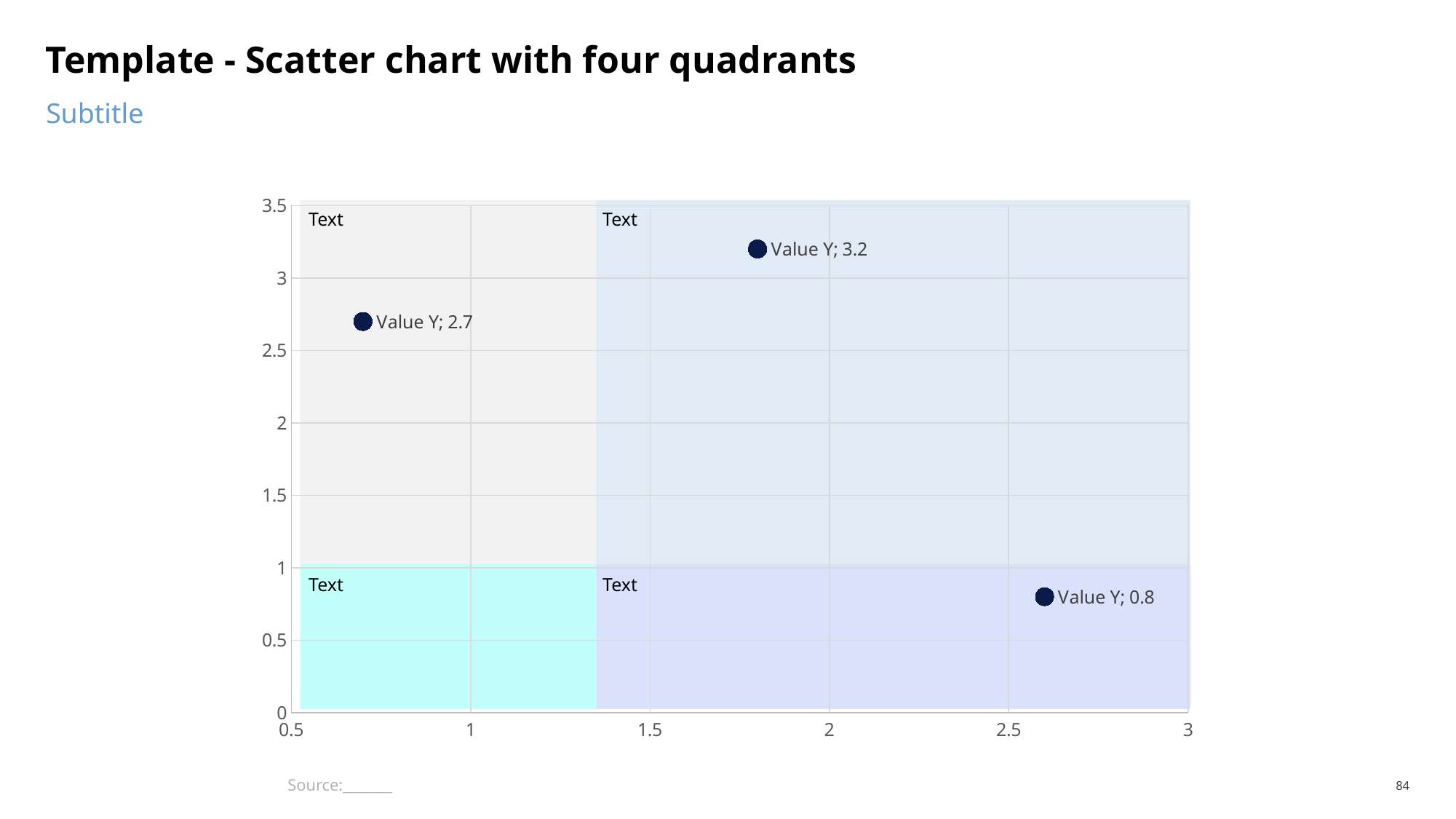
How many data points are plotted on the scatter chart? 3 What is the difference between the Y values 3.2 and 2.7 labelled on the scatter chart? 0.5 What is the title of the slide containing the scatter chart? Template - Scatter chart with four quadrants What is the lowest Y value labelled on the scatter chart? 0.8 Is the x value of the point labelled 'Value Y; 0.8' greater or less than 2.5? greater Is the x value of the point labelled 'Value Y; 3.2' greater or less than 1.5? greater Which labelled point has a larger Y value: the one at 'Value Y; 2.7' or the one at 'Value Y; 0.8'? Value Y; 2.7 What is the highest Y value labelled on the scatter chart? 3.2 Is the x value of the point labelled 'Value Y; 2.7' greater or less than 1? less How many quadrants is the scatter chart's plot area divided into? 4 What is the difference between the highest and lowest labelled Y values on the scatter chart? 2.4 What kind of chart is shown on the slide? scatter chart